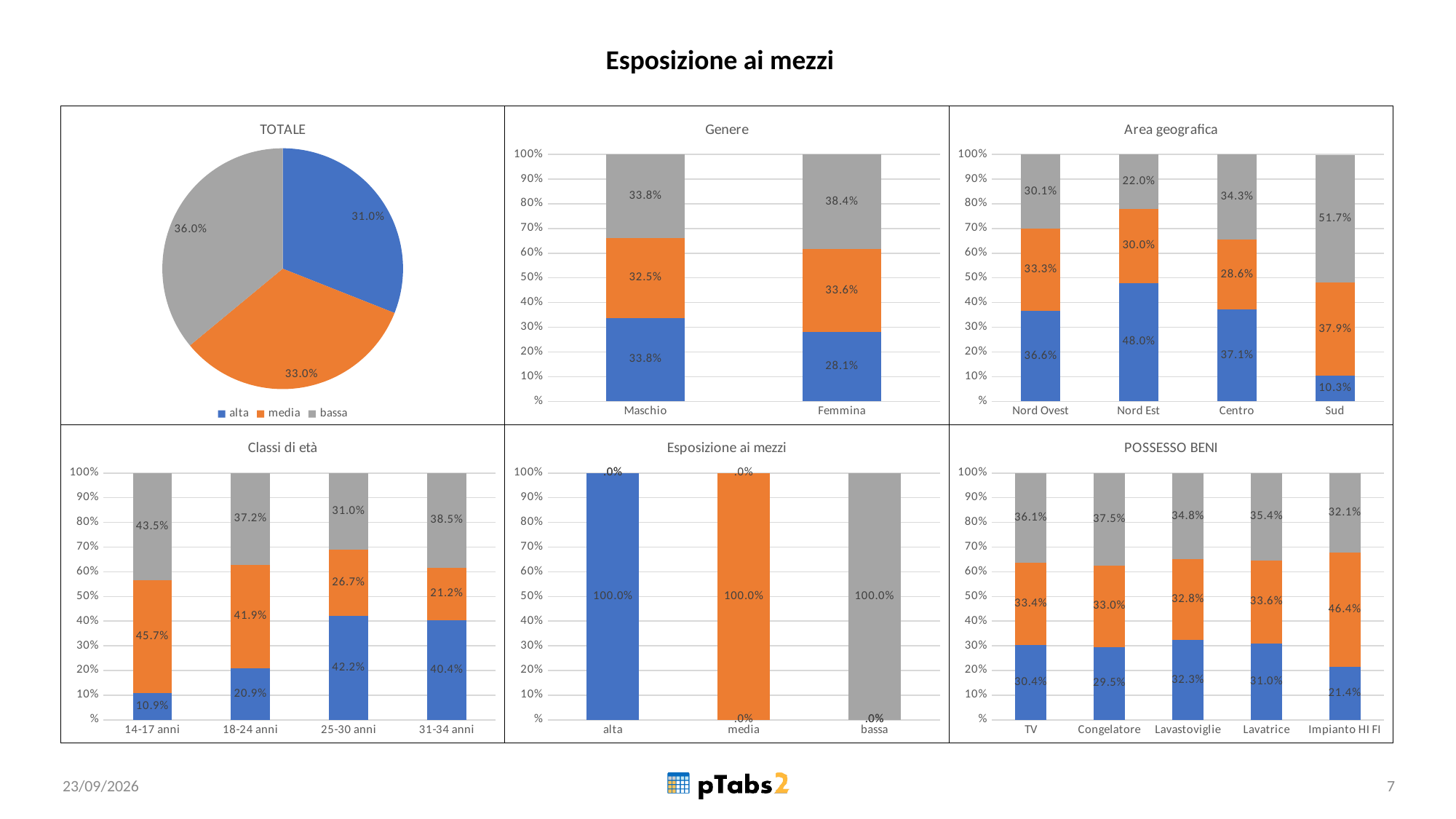
How many categories are shown on the x axis of the Classi di età chart? 4 In the Area geografica chart, what is the value of the top (grey, bassa) segment for Sud? 51.7% What kind of chart is the POSSESSO BENI chart? stacked bar chart In the Genere chart, what is the difference between the top (grey, bassa) segments of Femmina and Maschio? 4.6% In the Classi di età chart, is the middle (orange, media) segment larger for 14-17 anni or for 25-30 anni? 14-17 anni In the Classi di età chart, which category has the lowest bottom (blue, alta) segment? 14-17 anni In the Area geografica chart, which category has the highest bottom (blue, alta) segment? Nord Est In the POSSESSO BENI chart, what is the value of the middle (orange, media) segment for Impianto HI FI? 46.4% What kind of chart is the TOTALE chart? pie chart In the TOTALE pie chart, what share does the 'bassa' slice have? 36.0% In the Genere chart, what is the value of the bottom (blue, alta) segment for Femmina? 28.1% How many series does the legend of the TOTALE chart list? 3